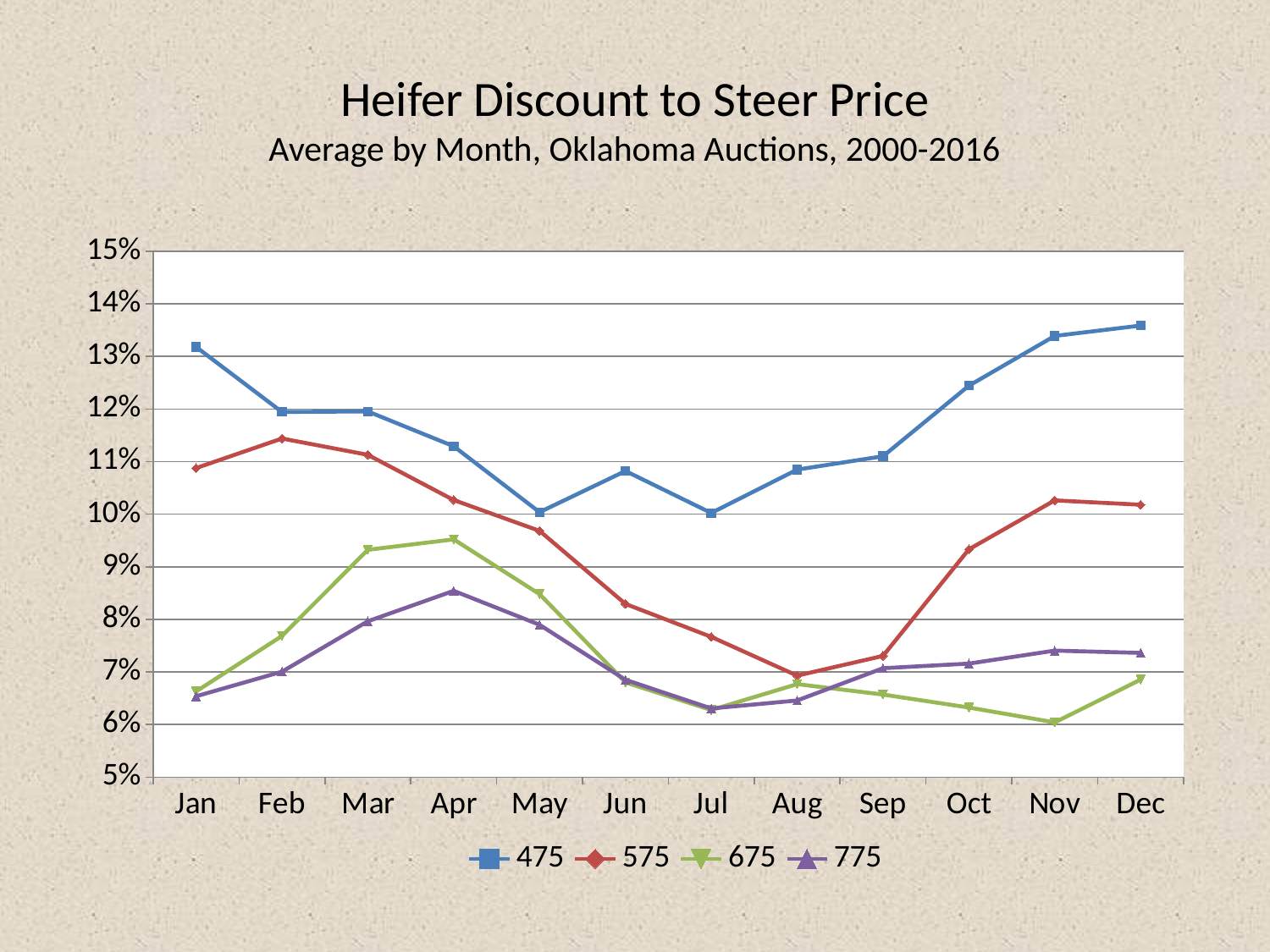
Is the value for the 475 series in Jul greater or less than 11%? less What kind of chart is shown on the slide? line chart In Dec, which series has the larger value, 675 or 775? 775 Does the 475 series rise or fall from Jul to Dec? rise In which month does the 675 series reach its lowest value? Nov In which month does the 775 series reach its highest value? Apr In which month does the 575 series reach its lowest value? Aug How many series does the legend list? 4 Is the value for the 475 series in Jan greater or less than 13%? greater Is the value for the 675 series in Mar greater or less than 9%? greater How many months are plotted along the x axis? 12 In which month does the 575 series reach its highest value? Feb